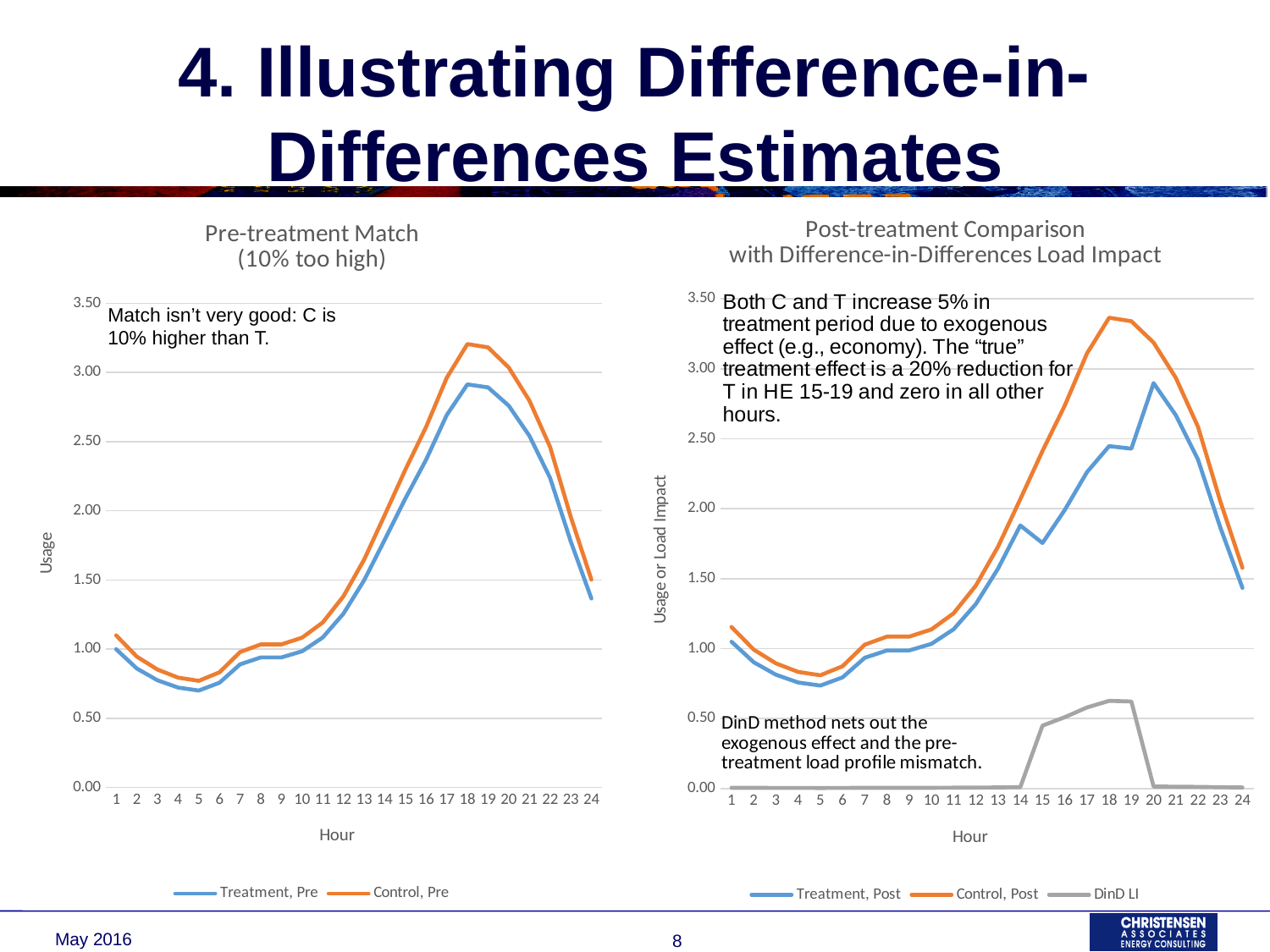
In the 'Post-treatment Comparison with Difference-in-Differences Load Impact' chart, which series is higher at hour 20, Treatment, Post or Control, Post? Control, Post How many series does the legend of the 'Pre-treatment Match (10% too high)' chart list? 2 In the 'Pre-treatment Match (10% too high)' chart, is the value for Control, Pre at hour 18 greater or less than 3.00? greater In the 'Post-treatment Comparison with Difference-in-Differences Load Impact' chart, which series has the lowest value at hour 1? DinD LI What is the y-axis title of the 'Post-treatment Comparison with Difference-in-Differences Load Impact' chart? Usage or Load Impact How many hours are plotted along the x axis of the 'Pre-treatment Match (10% too high)' chart? 24 What kind of chart is the 'Pre-treatment Match (10% too high)' chart? line chart How many series does the legend of the 'Post-treatment Comparison with Difference-in-Differences Load Impact' chart list? 3 In the 'Pre-treatment Match (10% too high)' chart, which series is higher at hour 18, Treatment, Pre or Control, Pre? Control, Pre In the 'Post-treatment Comparison with Difference-in-Differences Load Impact' chart, is the value for Treatment, Post at hour 20 greater or less than 2.50? greater In the 'Pre-treatment Match (10% too high)' chart, is the value for Treatment, Pre at hour 5 greater or less than 1.00? less